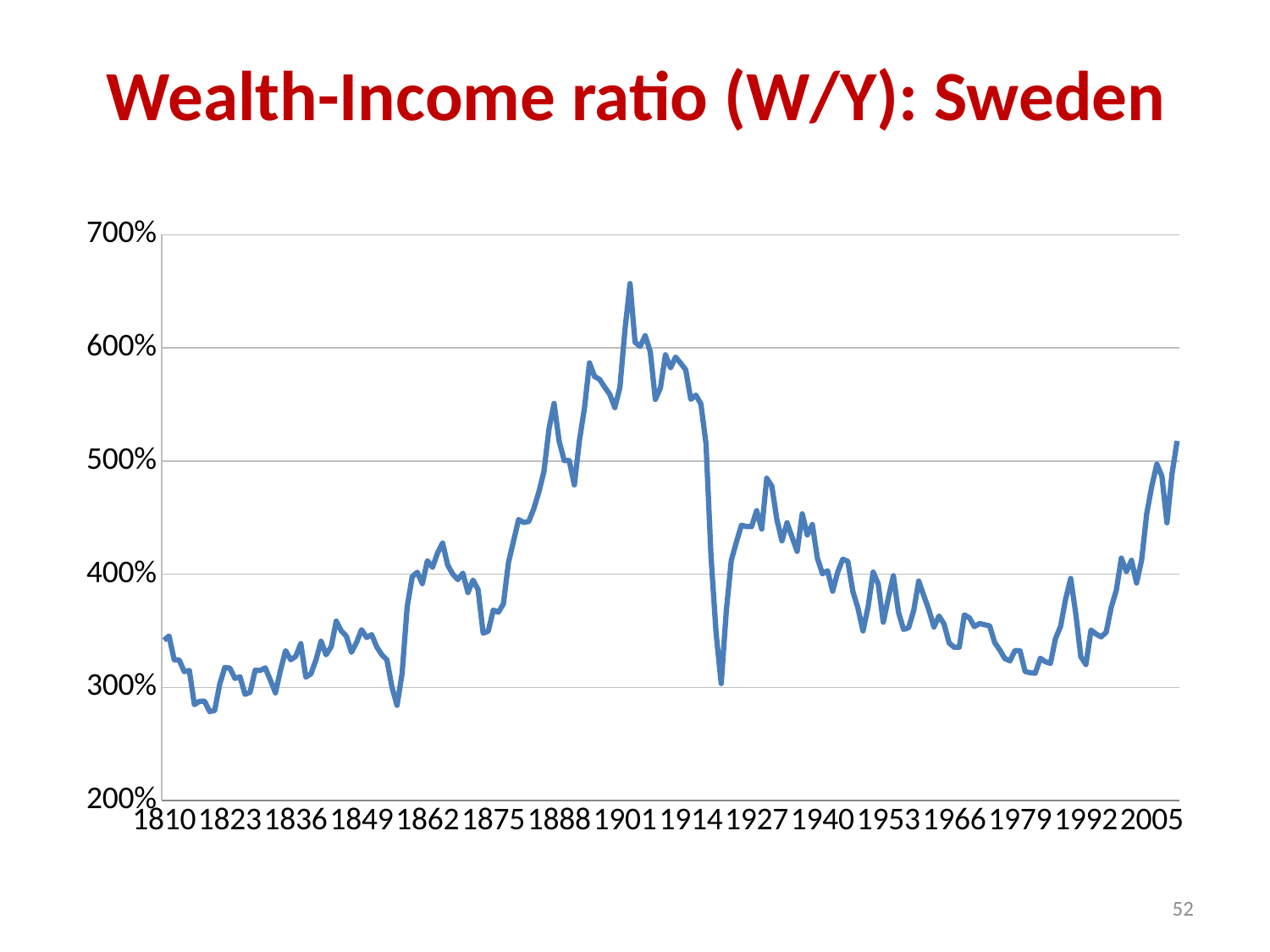
Is the value around 1953 greater or less than 400%? less Does the line generally rise or fall between 1810 and 1901? rise Is the value around 1901 greater or less than 600%? greater Which is larger, the value around 1901 or the value at 1810? 1901 Is the value at 1810 greater or less than 400%? less Near which labelled year does the line reach its highest point? 1901 How many year labels are shown on the x axis? 16 What kind of chart is shown on the slide? line chart What is the title of the chart? Wealth-Income ratio (W/Y): Sweden